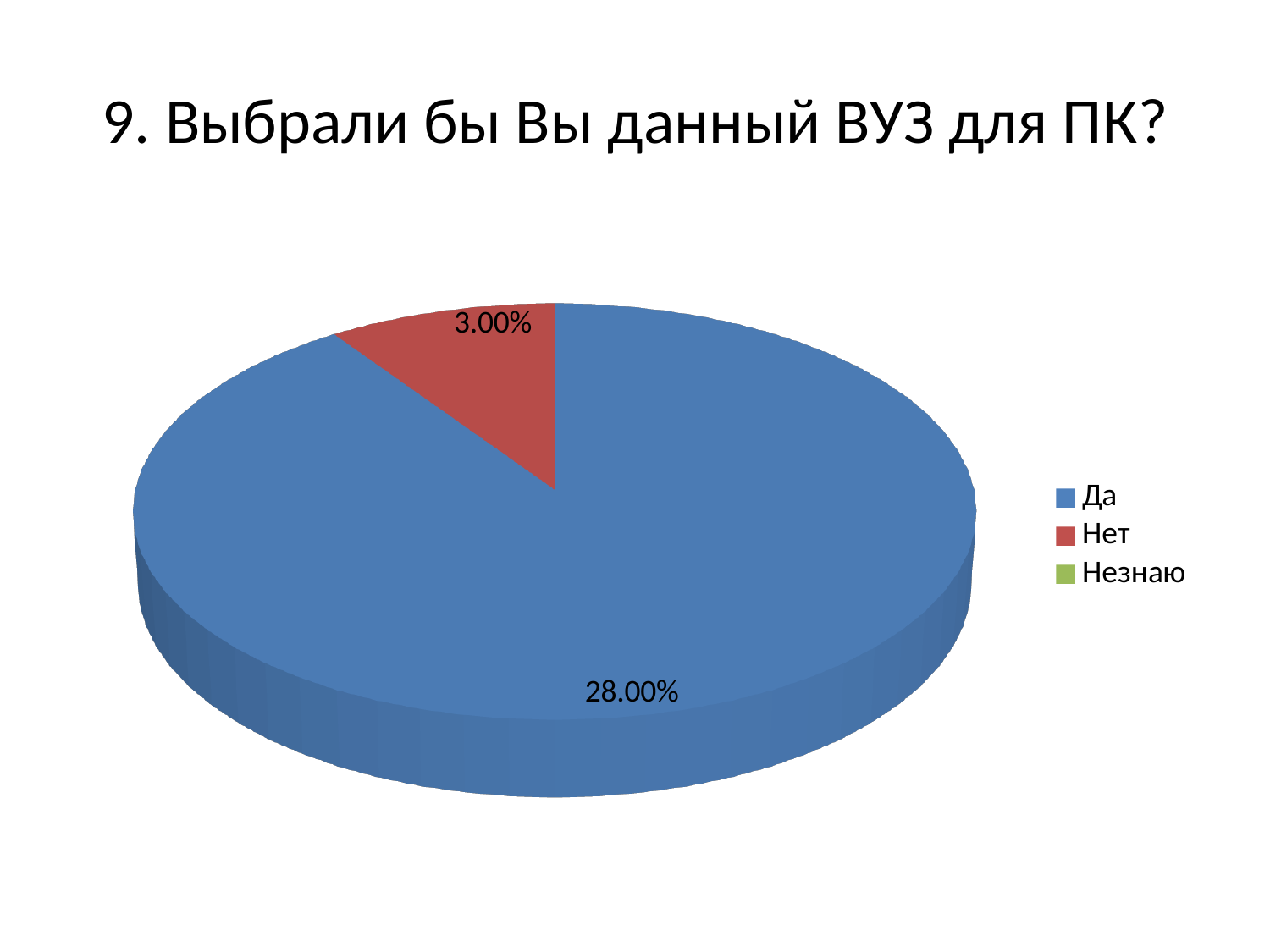
Which of the two labelled slices, Да or Нет, is smaller? Нет What is the difference between the values labelled for Да and Нет? 25.00% What colour is the Да slice? Blue What kind of chart is shown on the slide? Pie chart What value is shown for the Да slice? 28.00% How many entries does the legend list? 3 What is the title of the slide? 9. Выбрали бы Вы данный ВУЗ для ПК? How many slices are visible in the pie? 2 Which is larger, the value for Да or the value for Нет? Да What value is shown for the Нет slice? 3.00% Which category has the largest slice of the pie? Да